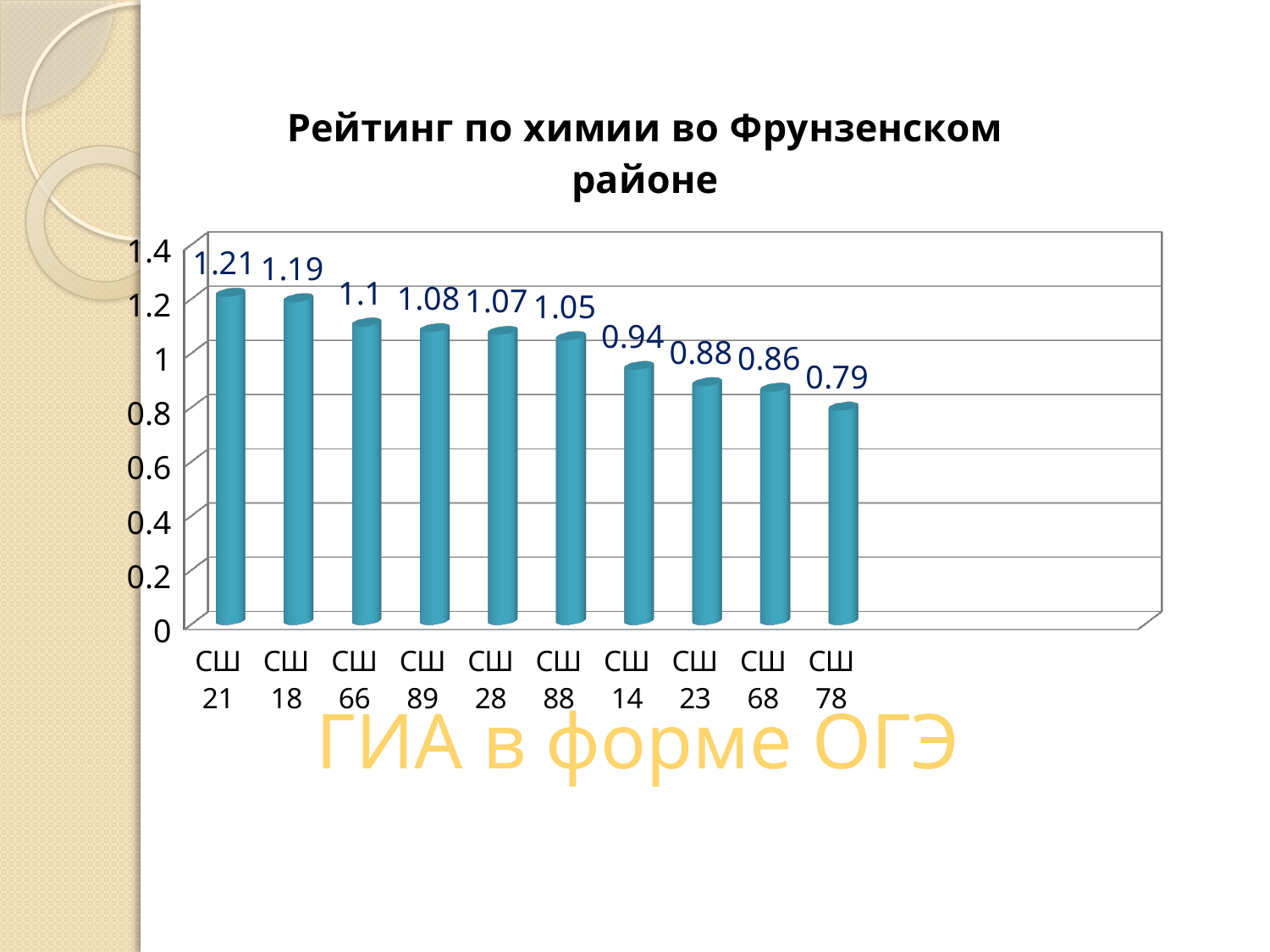
What is the value for СШ 78? 0.79 What is the value for СШ 14? 0.94 Which school has the highest value? СШ 21 What is the value for СШ 21? 1.21 What is the difference between the values for СШ 66 and СШ 23? 0.22 Which school has the lowest value? СШ 78 What is the difference between the values for СШ 21 and СШ 78? 0.42 Do the values rise or fall from left to right along the x axis? fall Which is larger, the value for СШ 18 or the value for СШ 88? СШ 18 What kind of chart is shown on the slide? bar chart Is the value for СШ 68 greater or less than 1? less How many schools are shown on the chart? 10